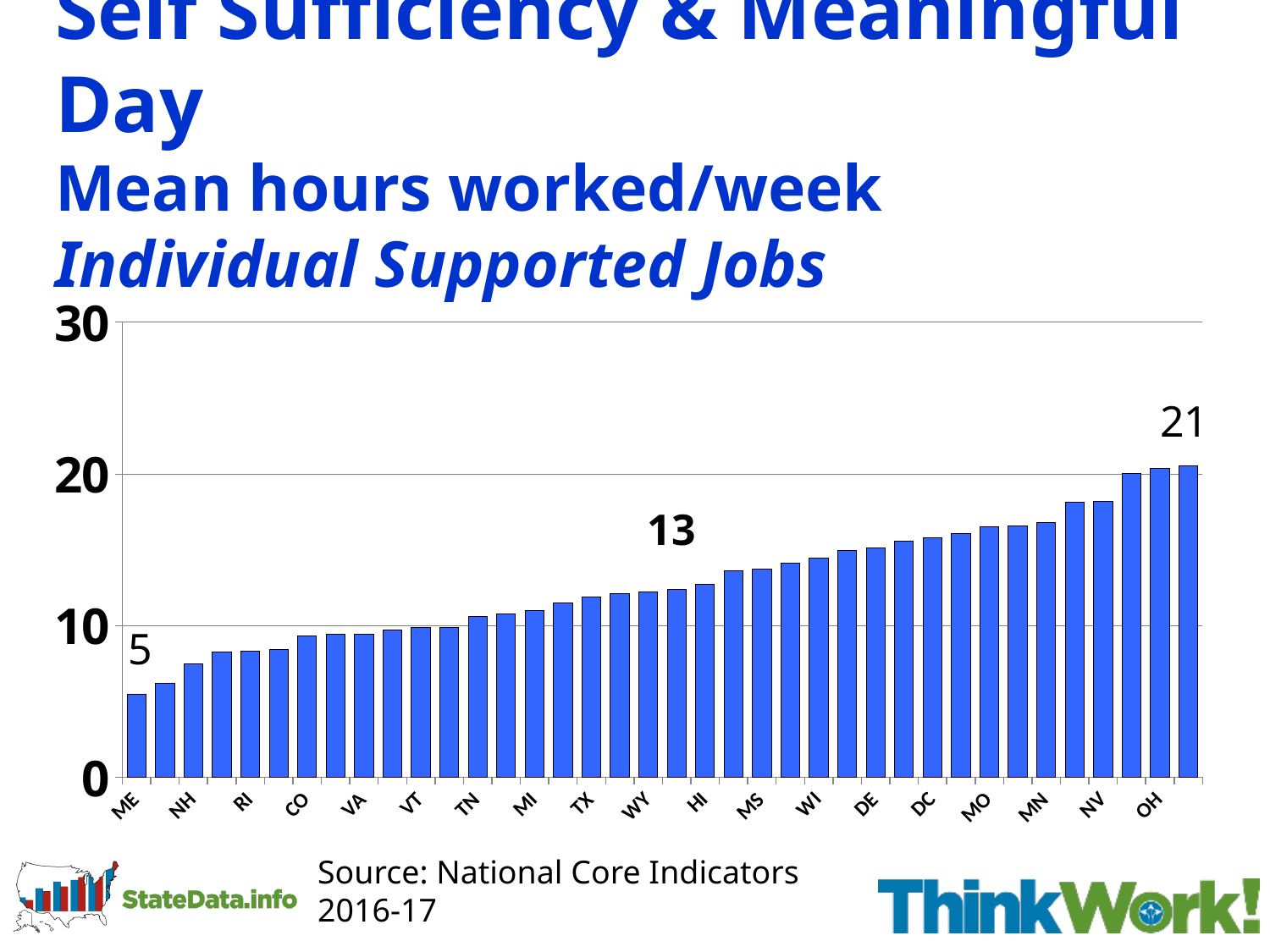
What is the source cited for the chart data? National Core Indicators 2016-17 Is the value for NH greater or less than 10? less Which has a higher mean hours worked per week, ME or OH? OH Which state has the lowest mean hours worked per week? ME What is the highest value shown on the y axis? 30 Do the bar values rise or fall from left to right along the x axis? rise What is the value of the highest bar in the chart? 21 Is the value for WI greater or less than 10? greater Is the value for NV greater or less than 20? less What is the difference between the highest bar value (21) and the lowest bar value (5)? 16 What kind of chart is shown on the slide? bar chart What is the mean hours worked per week for ME? 5